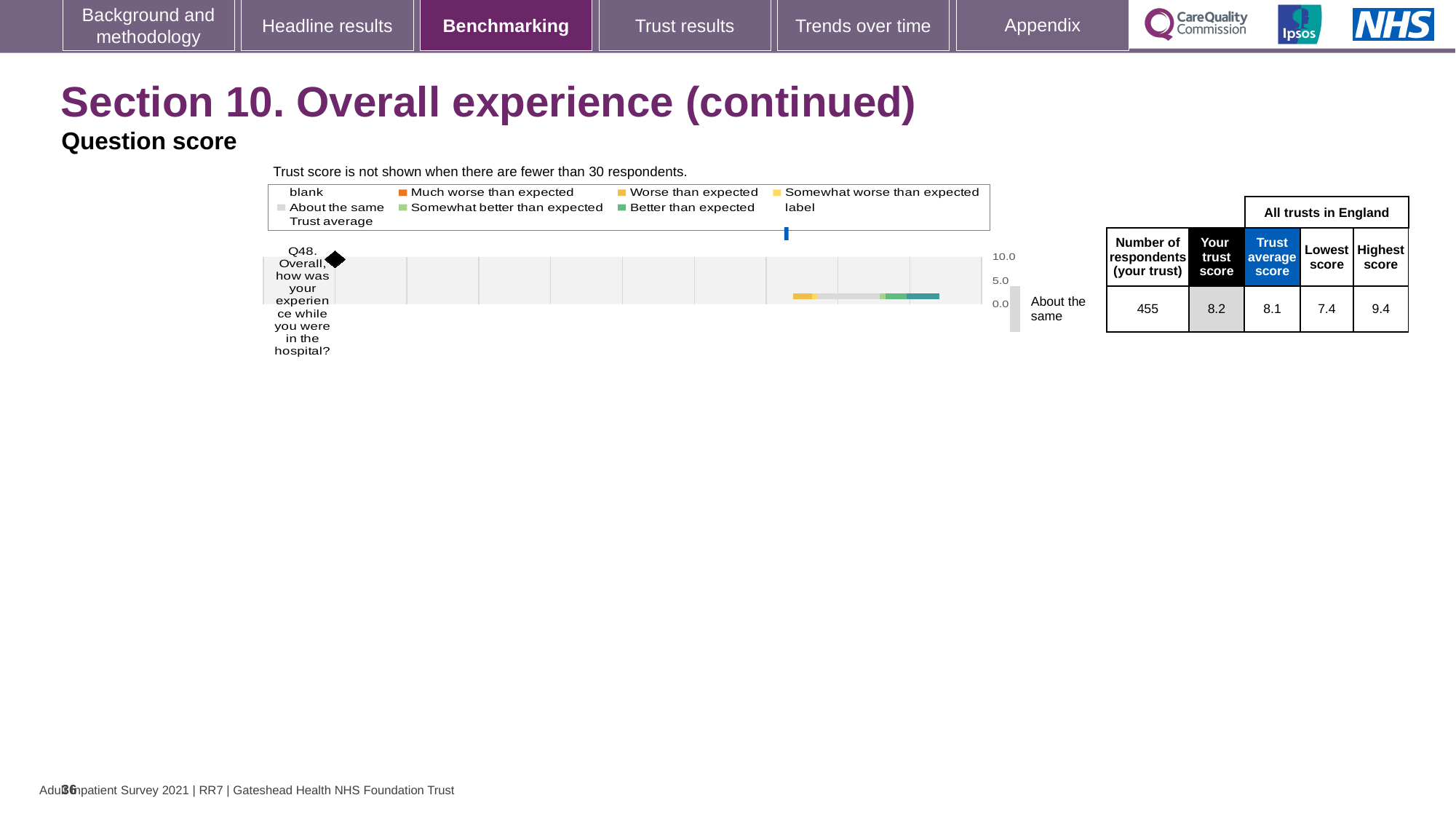
What is the difference between the highest score and the lowest score for Q48 across all trusts in England? 2.0 What kind of chart is used to show the Q48 benchmarking result? Bar chart Which is larger for Q48: your trust score or the trust average score? Your trust score What is the trust score for Q48 (Overall, how was your experience while you were in the hospital?) shown in the table? 8.2 How many questions are plotted in the benchmarking chart on this slide? 1 What is the trust average score across all trusts in England for Q48? 8.1 How many respondents from the trust answered Q48? 455 What is the difference between your trust score and the trust average score for Q48? 0.1 Is the trust score for Q48 greater or less than 5.0 on the chart axis? greater What is the highest score among all trusts in England for Q48? 9.4 How is the trust's result for Q48 categorised relative to other trusts? About the same What is the lowest score among all trusts in England for Q48? 7.4